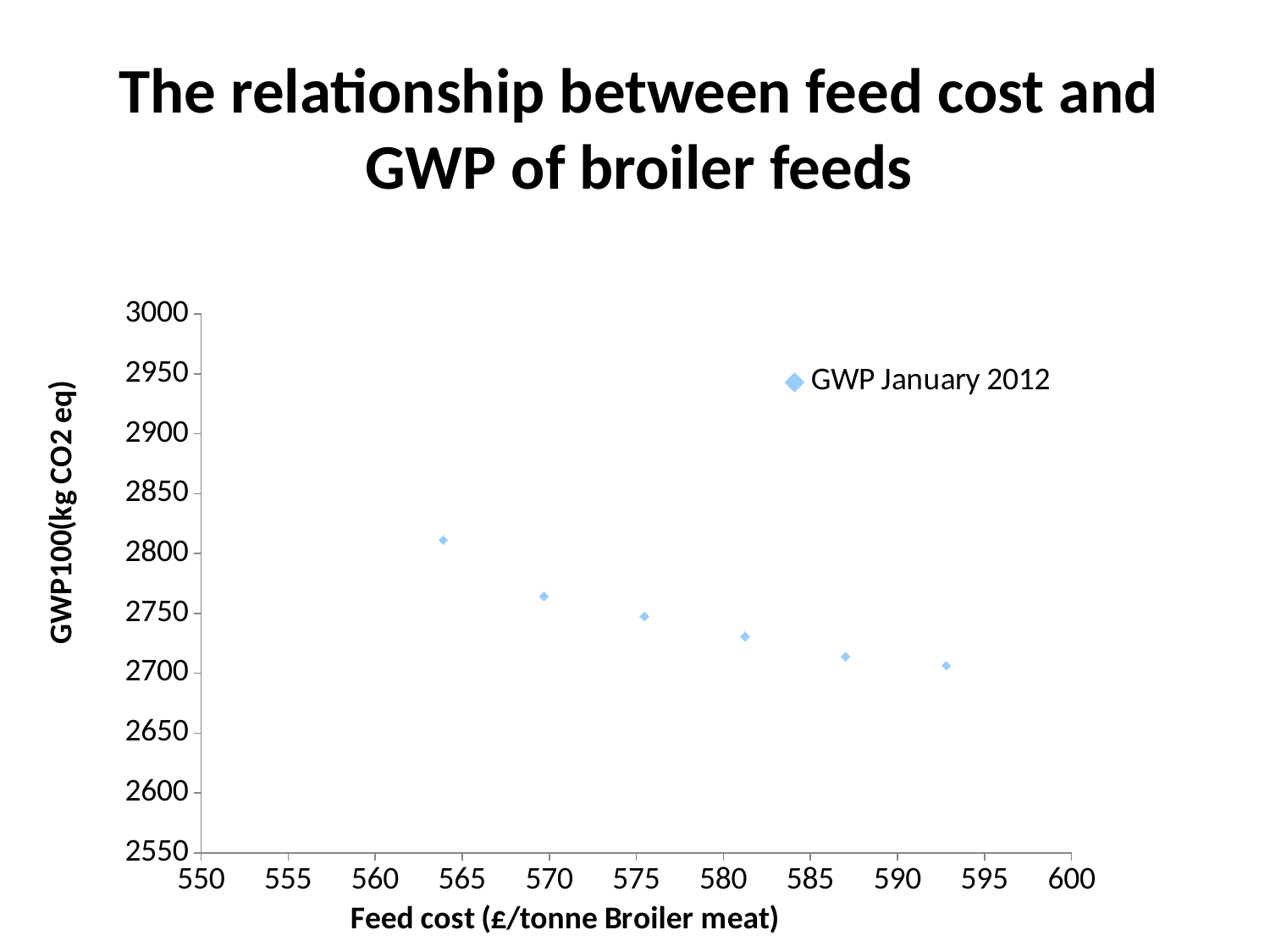
What is the name of the series shown in the legend? GWP January 2012 How many data points are plotted in the chart? 6 Is the GWP value of the point with the highest feed cost greater or less than 2650? greater What kind of chart is shown on the slide? Scatter chart How many series does the legend list? 1 Are all plotted points above or below 2900 on the y axis? below Is the GWP value of the point with the lowest feed cost greater or less than 2850? less Which has the higher GWP: the point with the lowest feed cost or the point with the highest feed cost? The point with the lowest feed cost What is the title of the chart? The relationship between feed cost and GWP of broiler feeds As feed cost increases along the x axis, does GWP rise or fall? Fall